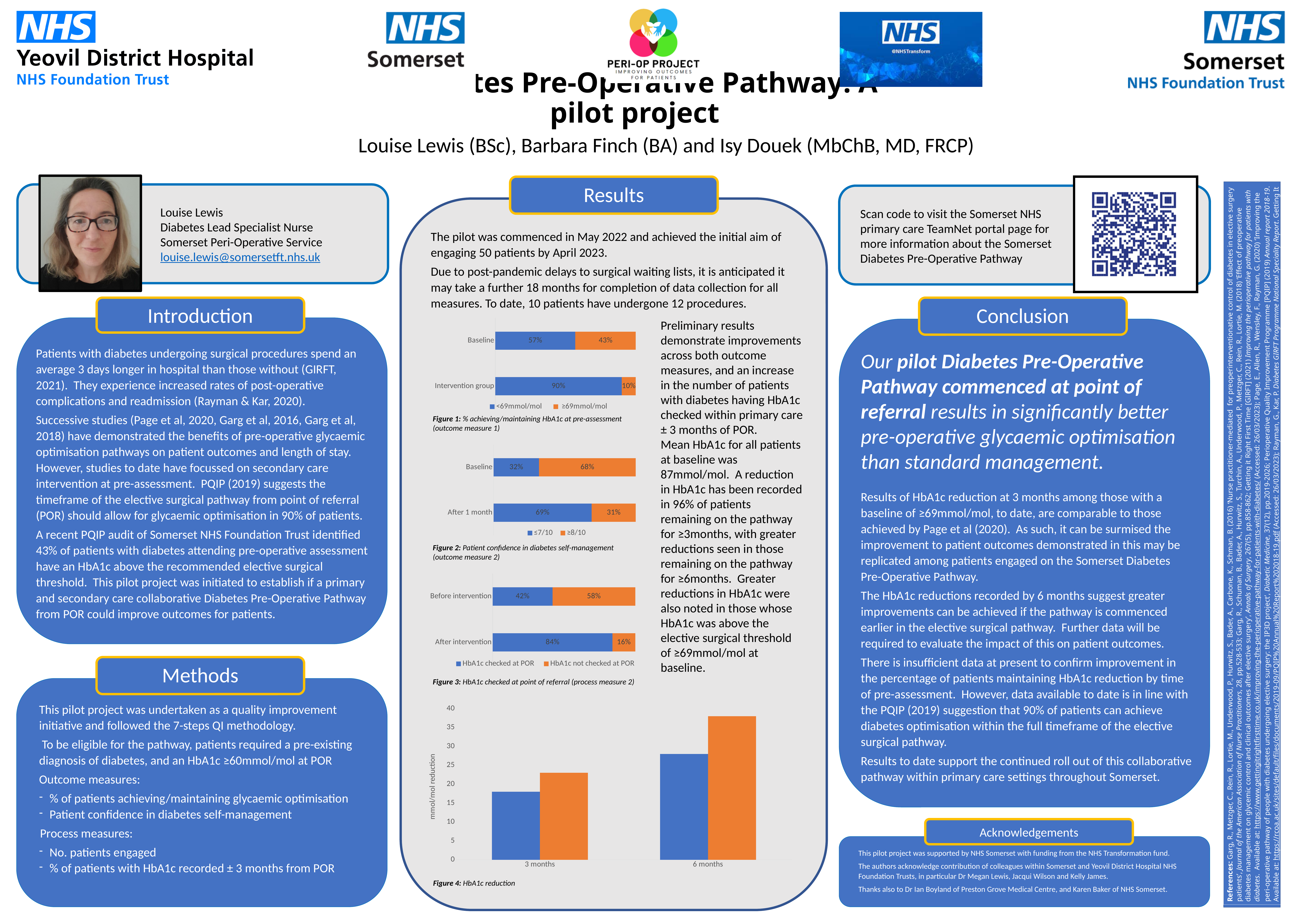
In Figure 2 (Patient confidence in diabetes self-management), which is larger at Baseline: the ≤7/10 share or the ≥8/10 share? ≥8/10 In Figure 3 (HbA1c checked at point of referral), what percentage of patients had HbA1c checked at POR after intervention? 84% In Figure 1 (% achieving/maintaining HbA1c at pre-assessment), what percentage of the Intervention group had HbA1c <69mmol/mol? 90% In Figure 1 (% achieving/maintaining HbA1c at pre-assessment), what is the difference between the <69mmol/mol share for the Intervention group and for Baseline? 33% In Figure 4 (HbA1c reduction), is the value of the orange bar at 6 months greater or less than 35? greater In Figure 4 (HbA1c reduction), what kind of chart is shown? Bar chart In Figure 3 (HbA1c checked at point of referral), what is the difference between the HbA1c checked at POR share after intervention and before intervention? 42% In Figure 3 (HbA1c checked at point of referral), what percentage of patients had HbA1c not checked at POR before intervention? 58% In Figure 4 (HbA1c reduction), is the value of the blue bar at 3 months greater or less than 20? less In Figure 2 (Patient confidence in diabetes self-management), what percentage of patients scored ≤7/10 after 1 month? 69% In Figure 1 (% achieving/maintaining HbA1c at pre-assessment), what percentage of the Baseline group had HbA1c ≥69mmol/mol? 43% In Figure 2 (Patient confidence in diabetes self-management), how many series does the legend list? 2